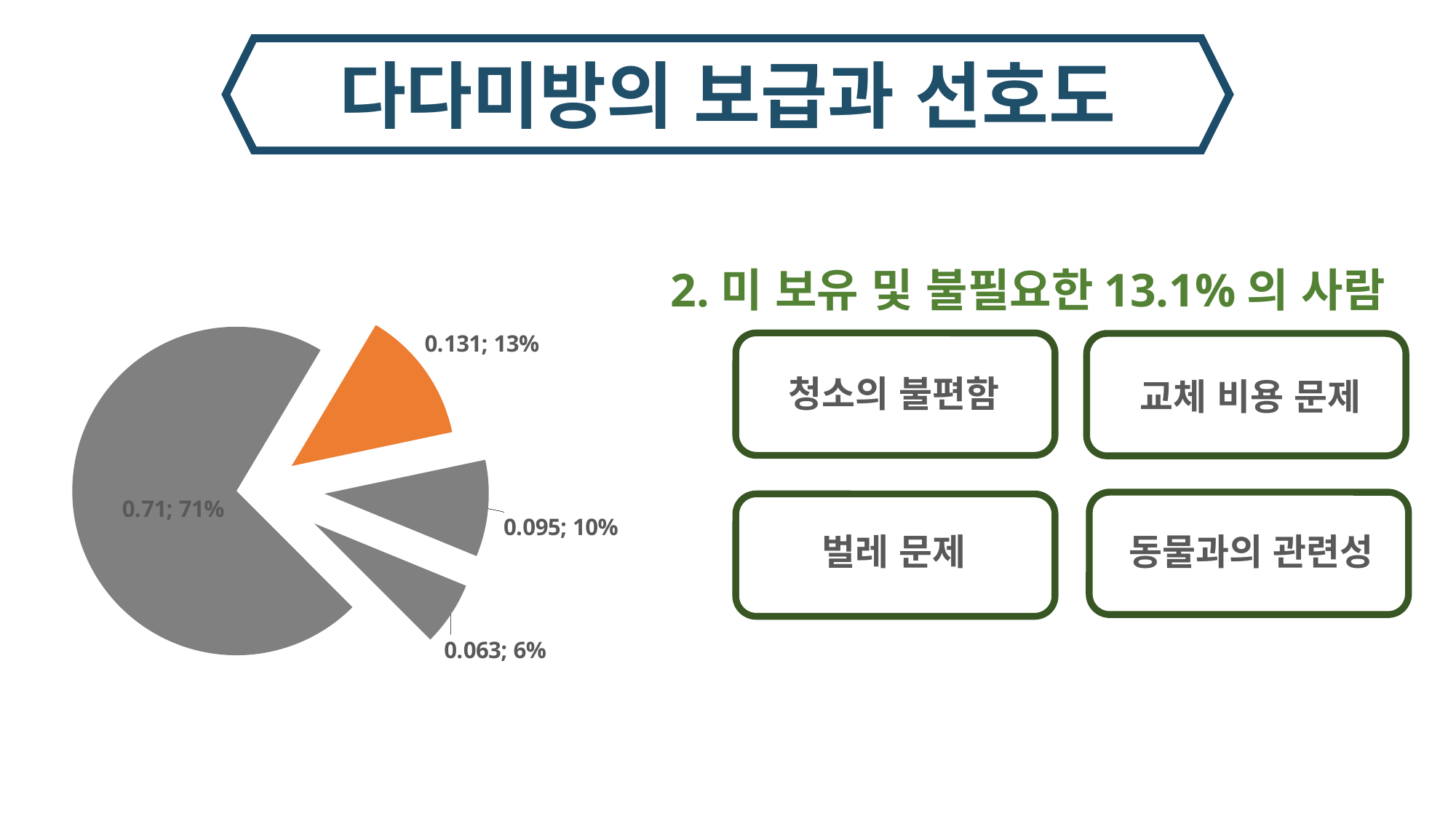
How many slices does the pie chart have? 4 What is the value of the largest slice of the pie chart? 0.71 What percentage share does the orange slice of the pie chart have? 13% Which is larger in the pie chart: the orange slice (0.131) or the slice labelled 0.095? the orange slice (0.131) Which slice of the pie chart is highlighted in a different colour from the others? the 0.131; 13% slice (orange) What is the value of the smallest slice of the pie chart? 0.063 What is the difference between the largest slice value (0.71) and the orange slice value (0.131)? 0.579 How many slices of the pie chart are coloured grey? 3 What kind of chart is shown on the slide? pie chart What percentage share does the largest slice of the pie chart have? 71% What is the data label on the orange slice of the pie chart? 0.131; 13% What is the difference in percentage points between the slice labelled 10% and the slice labelled 6%? 4%